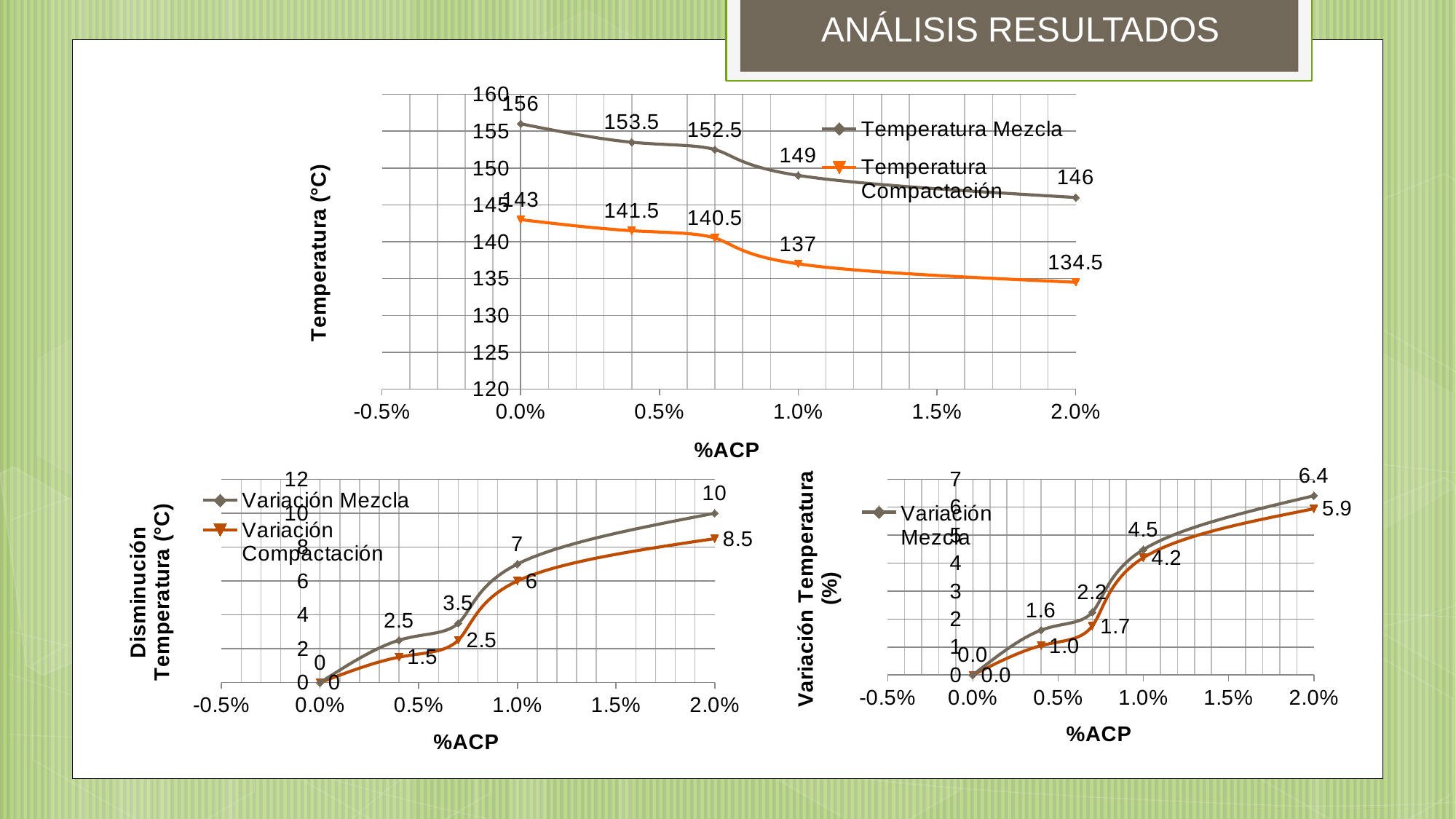
In the top chart, what is the Temperatura Compactación value at 2.0% ACP? 134.5 In the bottom-left chart, how many data points does the Variación Mezcla series have? 5 In the top chart, what is the difference between Temperatura Mezcla and Temperatura Compactación at 1.0% ACP? 12 What is the x-axis title of the top chart? %ACP In the bottom-left chart, what is the Variación Compactación value at 1.0% ACP? 6 In the bottom-right chart, what is the highest Variación Mezcla value shown? 6.4 In the bottom-left chart, what is the Variación Mezcla value at 2.0% ACP? 10 What type of chart is the top chart? line chart In the top chart, how many series does the legend list? 2 In the top chart, do the Temperatura Mezcla values rise or fall as %ACP increases? fall In the bottom-right chart, which series has the larger value at 2.0% ACP, the one labelled 6.4 or the one labelled 5.9? the one labelled 6.4 (Variación Mezcla) In the top chart, what is the Temperatura Mezcla value at 0.0% ACP? 156